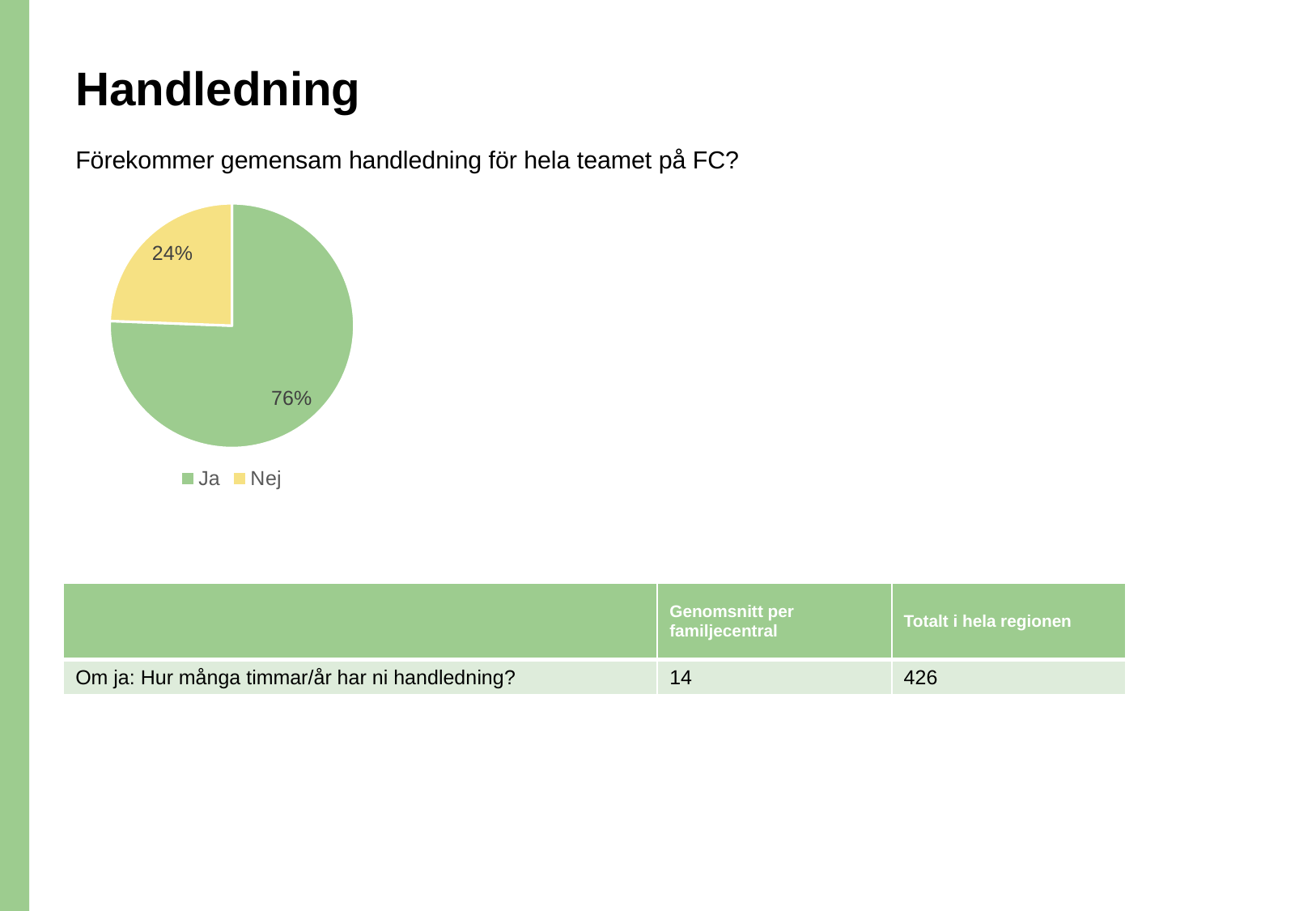
What question does the pie chart answer, according to the text above it? Förekommer gemensam handledning för hela teamet på FC? Which slice of the pie is the smallest? Nej Which slice of the pie is the largest? Ja What colour is the "Nej" slice in the pie chart? yellow How many entries does the legend list? 2 What is the difference in percentage points between the "Ja" and "Nej" slices? 52 What share of the pie does "Ja" represent? 76% What kind of chart is shown on the slide? pie chart Which is larger, the share for "Ja" or the share for "Nej"? Ja What share of the pie does "Nej" represent? 24% How many slices does the pie chart have? 2